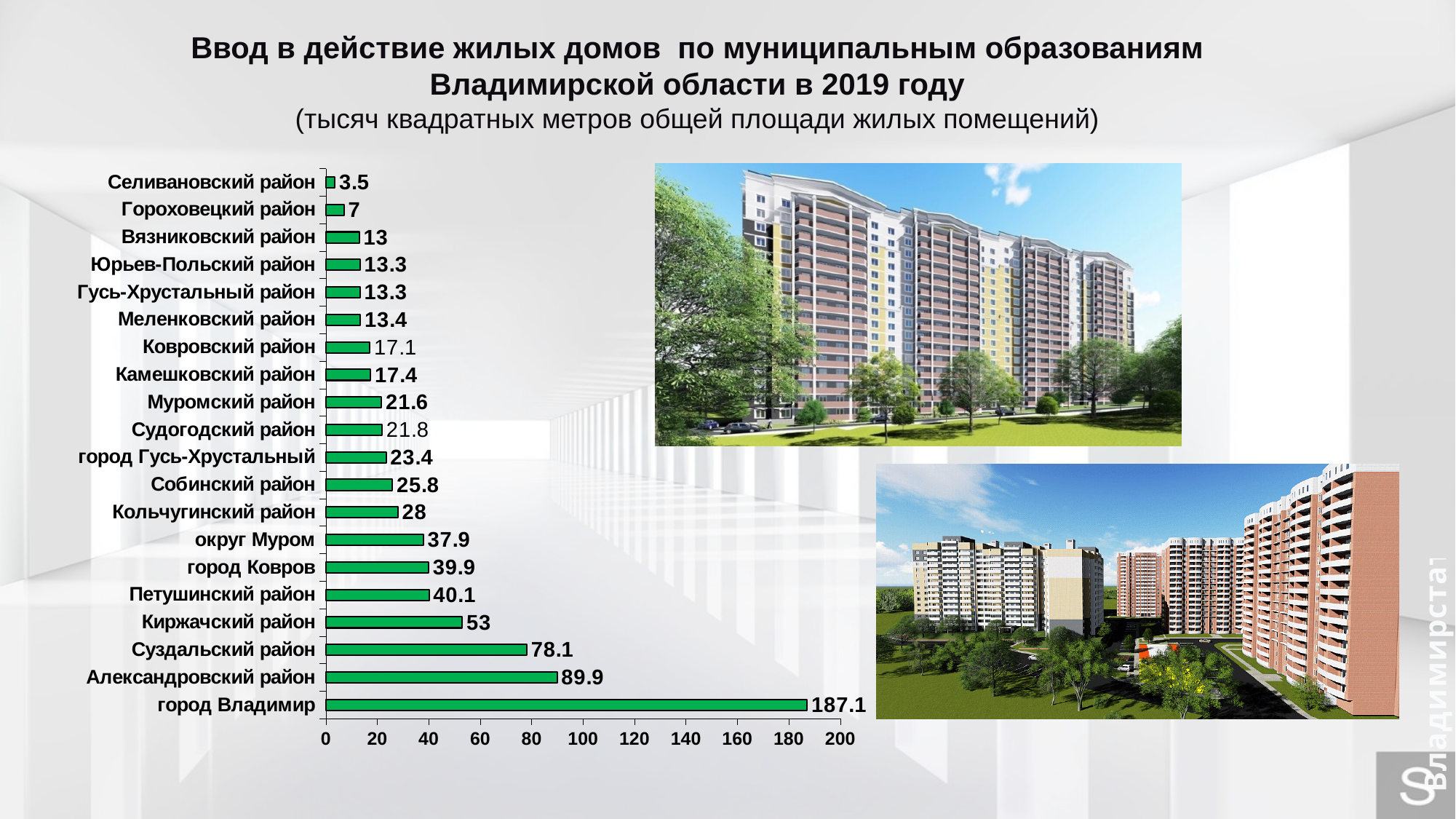
Is the value for Александровский район greater or less than 100? less What is the value for Киржачский район? 53 What is the value for Селивановский район? 3.5 What is the difference between the values for город Владимир and Александровский район? 97.2 What colour are the bars in the chart? green What is the value for Суздальский район? 78.1 What kind of chart is shown on the slide? bar chart What is the value for город Владимир? 187.1 Which municipality has the highest value? город Владимир Which is larger, the value for Петушинский район or the value for округ Муром? Петушинский район How many municipalities are shown in the chart? 20 Which municipality has the lowest value? Селивановский район